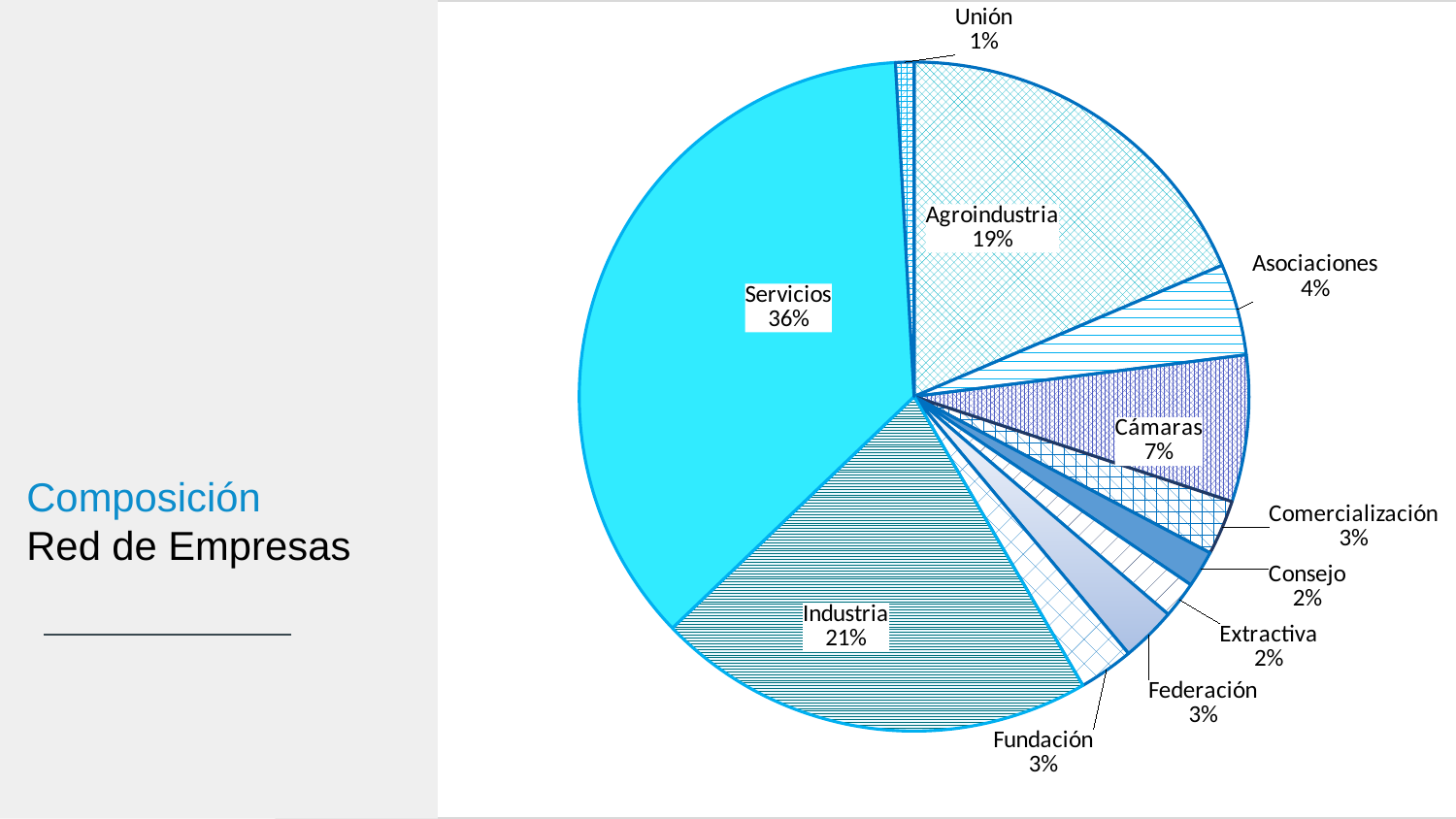
What is the difference in percentage points between Servicios and Industria? 15 What is the value shown for Cámaras? 7% What is the title text shown to the left of the chart? Composición Red de Empresas Which category has the largest slice of the pie? Servicios What is the value shown for Agroindustria? 19% How many slices does the pie chart have? 11 Which category has the smallest slice of the pie? Unión What is the value shown for Unión? 1% What is the value shown for Asociaciones? 4% What kind of chart is shown on the slide? pie chart What share of the pie does Servicios hold? 36% Which is larger, Agroindustria or Industria? Industria